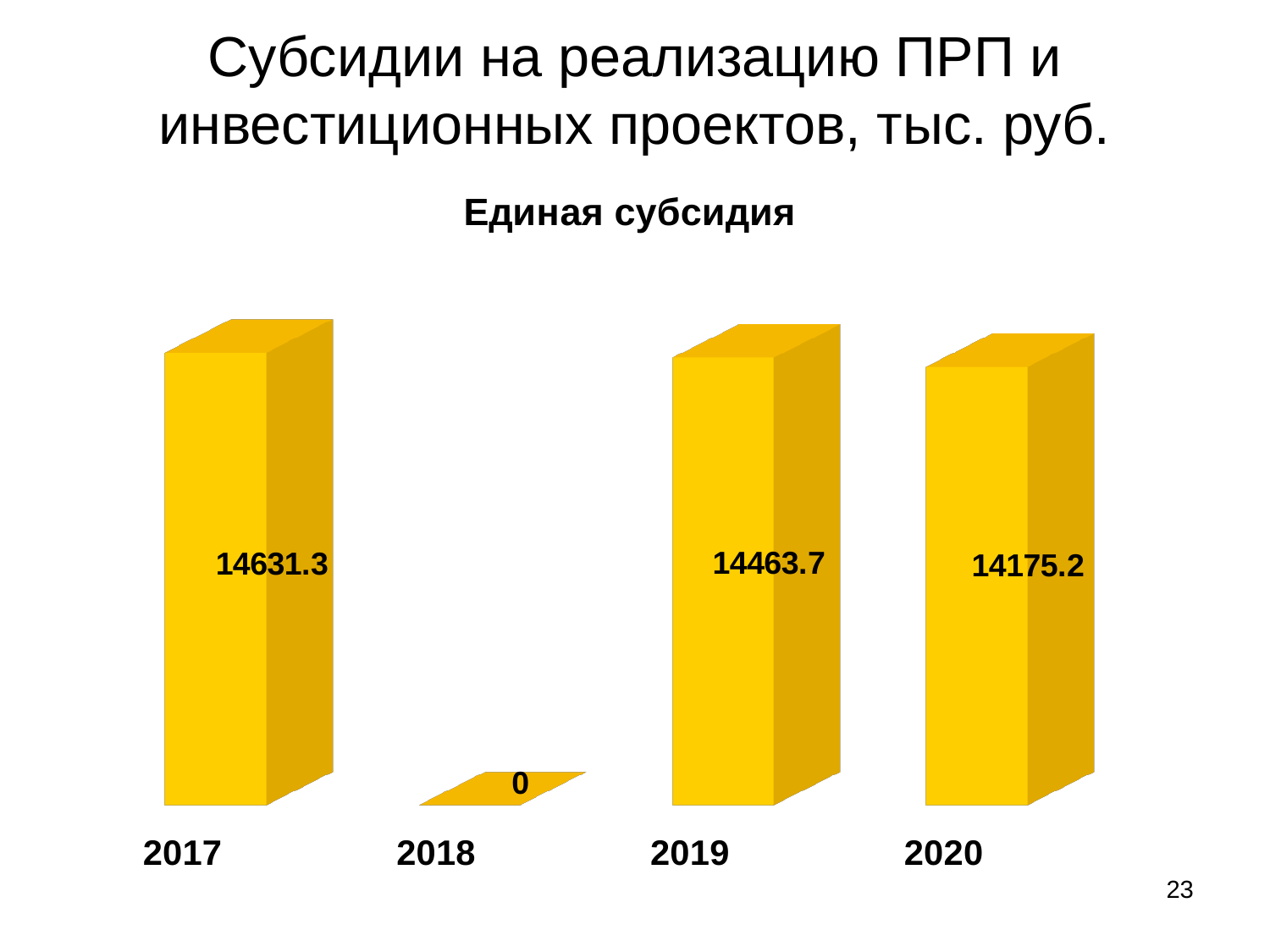
What is the value for 2020? 14175.2 What is the difference between the values for 2017 and 2019? 167.6 What kind of chart is shown on the slide? bar chart Which year has the highest value? 2017 What is the value for 2018? 0 What is the difference between the values for 2019 and 2020? 288.5 What is the title of the chart? Единая субсидия Which is larger, the value for 2019 or the value for 2020? 2019 What is the value for 2019? 14463.7 What is the value for 2017? 14631.3 How many years are shown on the x axis? 4 Which year has the lowest value? 2018